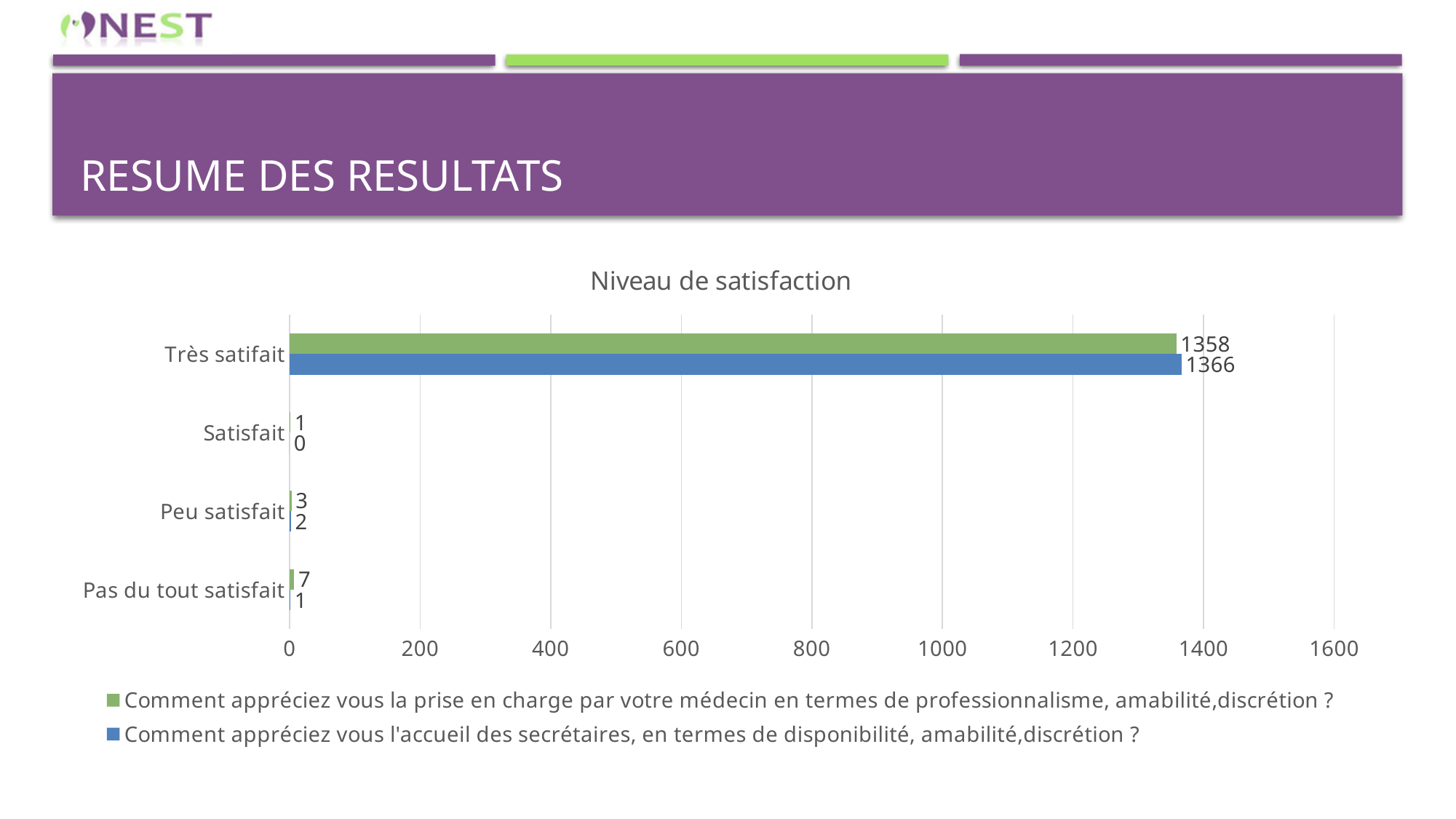
What type of chart is shown on the slide? Bar chart What is the difference between the two series' values for "Très satifait"? 8 What is the value for "Satisfait" in the series about the accueil des secrétaires? 0 What is the value for "Peu satisfait" in the series about the accueil des secrétaires? 2 Which category has the highest value in the series about the accueil des secrétaires? Très satifait What is the value for "Très satifait" in the series about the médecin (professionnalisme, amabilité, discrétion)? 1358 Which category has the lowest value in the series about the médecin? Satisfait What is the value for "Très satifait" in the series about the accueil des secrétaires? 1366 What is the value for "Pas du tout satisfait" in the series about the médecin? 7 For "Pas du tout satisfait", which series has the larger value: the médecin series or the secrétaires series? The médecin series How many series does the legend list? 2 How many categories are shown on the chart? 4